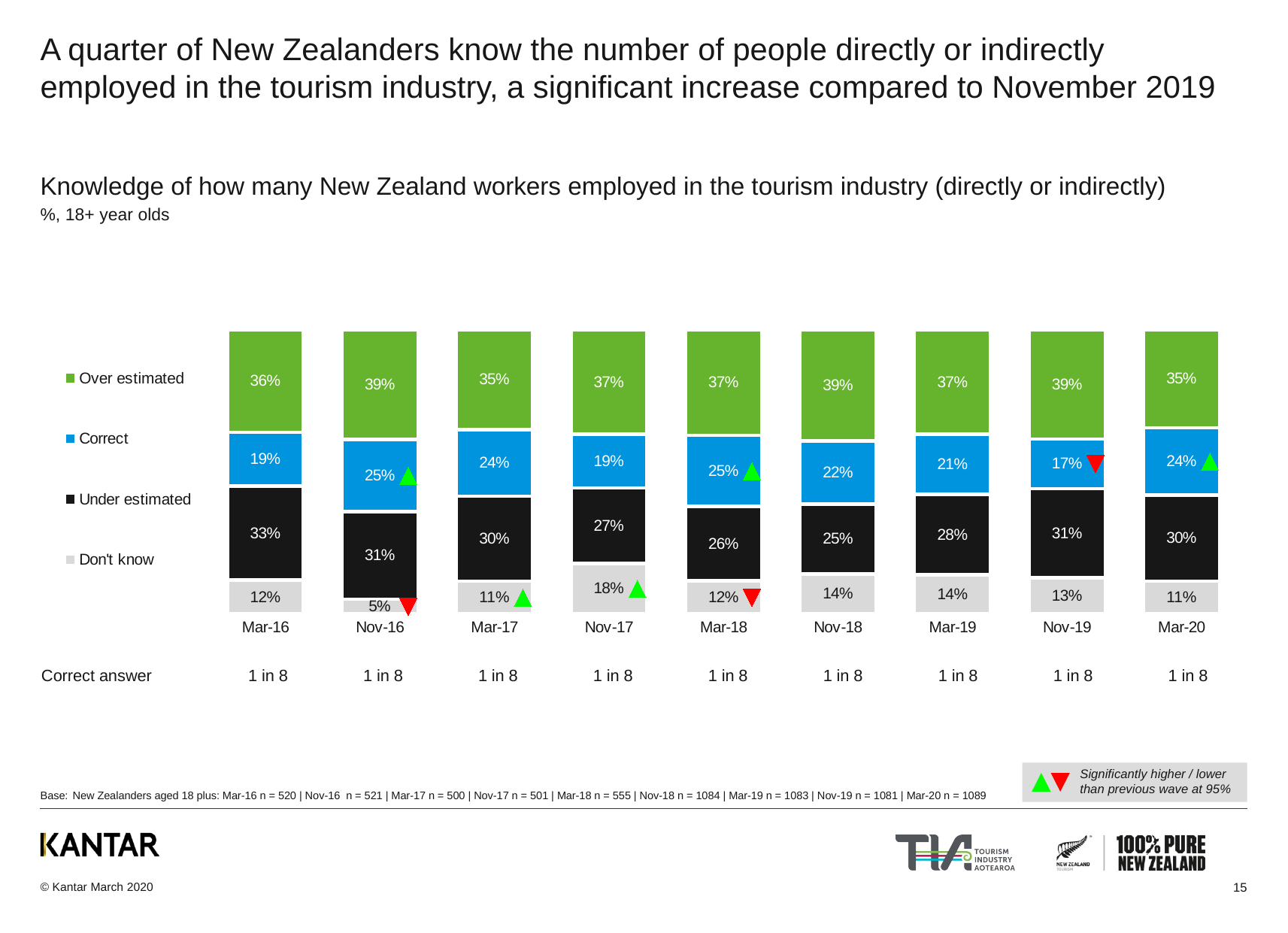
In which wave is the 'Don't know' share highest? Nov-17 What kind of chart is shown on the slide? Stacked bar chart What percentage of respondents gave the correct answer in Mar-20? 24% What is the 'Don't know' value for Nov-16? 5% How many waves (time periods) are shown on the x axis? 9 Which colour represents the 'Over estimated' series in the legend? Green How many series does the legend list? 4 What is the 'Under estimated' value for Nov-17? 27% What is the difference between the 'Correct' values for Mar-20 and Nov-19? 7% Which is larger, the 'Under estimated' value for Mar-16 or for Mar-18? Mar-16 What is the total of the stacked bar for Nov-16? 100% In which wave is the 'Correct' share lowest? Nov-19